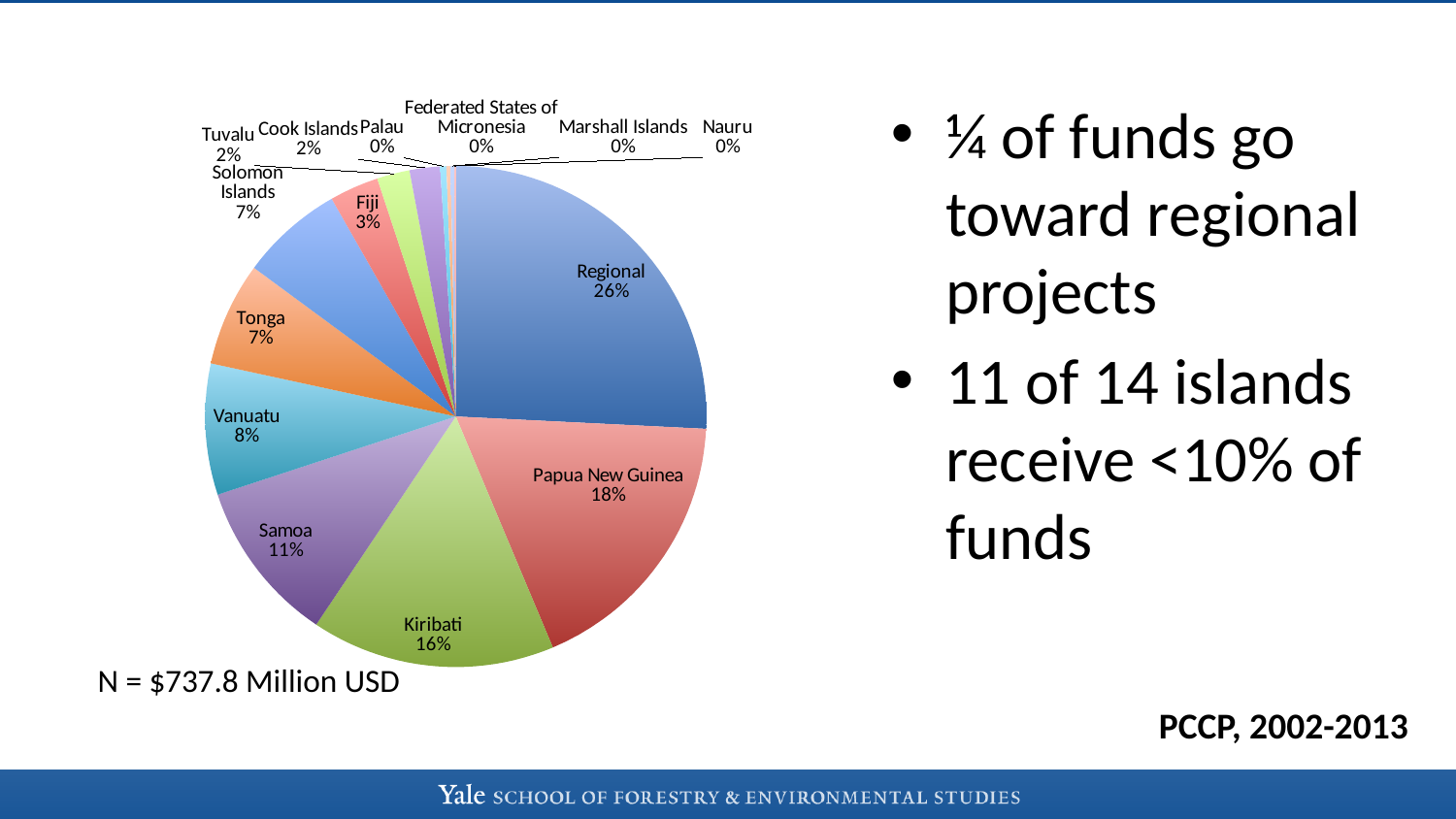
What percentage of funds does Samoa receive? 11% What share of funds goes to Regional projects in the pie chart? 26% Which receives a larger share of funds, Papua New Guinea or Kiribati? Papua New Guinea What is the difference in percentage points between the Regional share and the Samoa share? 15 What percentage of funds does Papua New Guinea receive? 18% What total amount (N) does the pie chart represent, as stated on the slide? $737.8 Million USD Which slice of the pie chart is the largest? Regional What kind of chart is shown on the slide? pie chart What percentage of funds does Vanuatu receive? 8% What percentage of funds does Fiji receive? 3% How many slices (categories) does the pie chart have? 14 What percentage of funds does Kiribati receive? 16%